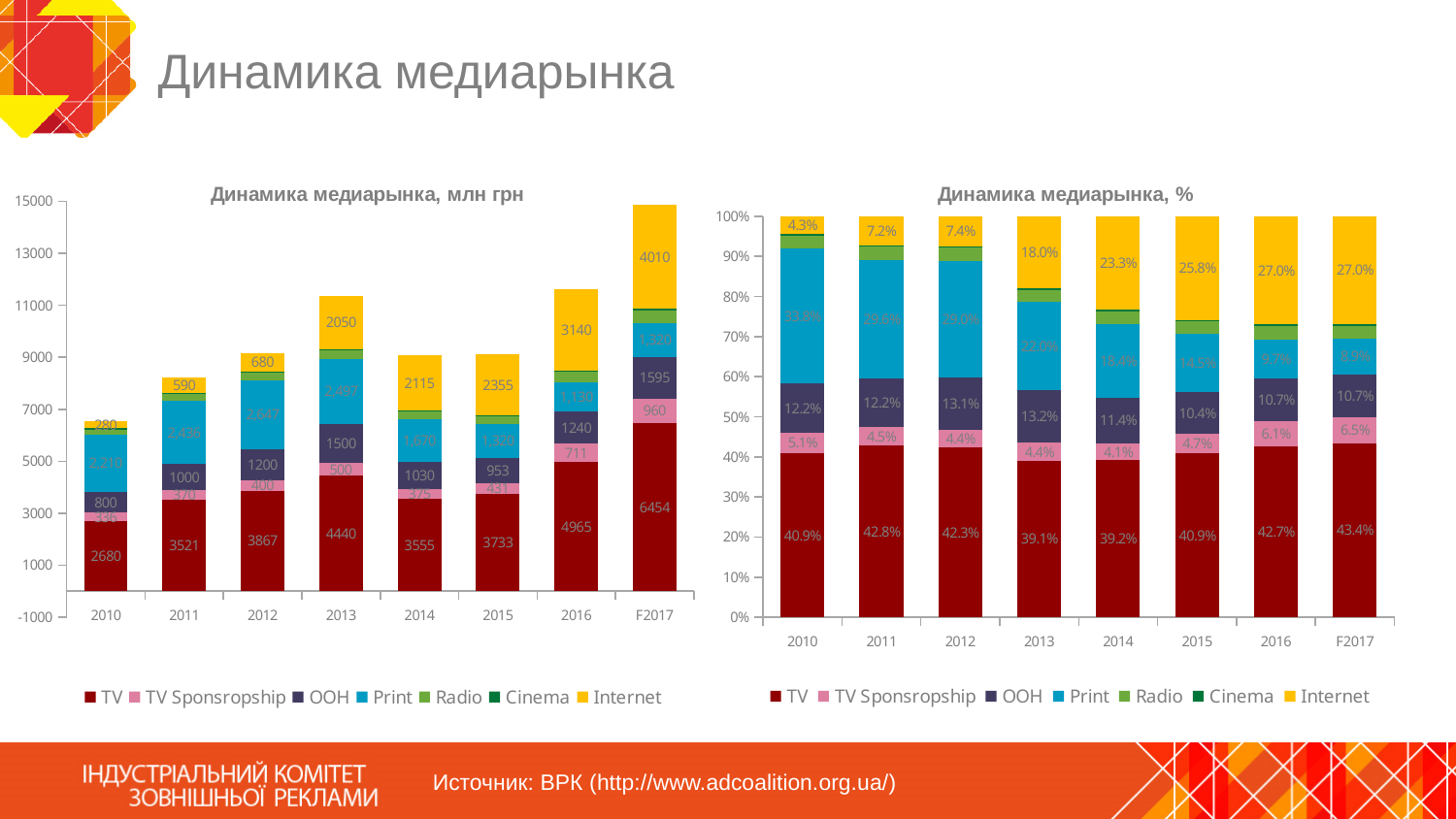
In the chart 'Динамика медиарынка, млн грн', what is the Internet value for 2013? 2050 In the chart 'Динамика медиарынка, %', what is the Internet share for 2014? 23.3% How many years are shown on the x axis of the chart 'Динамика медиарынка, млн грн'? 8 In the chart 'Динамика медиарынка, млн грн', which year has the lowest Internet value? 2010 In the chart 'Динамика медиарынка, %', what is the TV share for 2013? 39.1% In the chart 'Динамика медиарынка, млн грн', which is larger: the Internet value for 2014 or the Internet value for 2015? 2015 In the chart 'Динамика медиарынка, %', does the Print share rise or fall from 2010 to F2017? fall In the chart 'Динамика медиарынка, млн грн', which year has the highest TV value? F2017 In the chart 'Динамика медиарынка, млн грн', what is the difference between the TV values for F2017 and 2016? 1489 In the chart 'Динамика медиарынка, млн грн', what is the TV value for F2017? 6454 In the chart 'Динамика медиарынка, млн грн', what is the OOH value for 2011? 1000 How many series does the legend of the chart 'Динамика медиарынка, %' list? 7